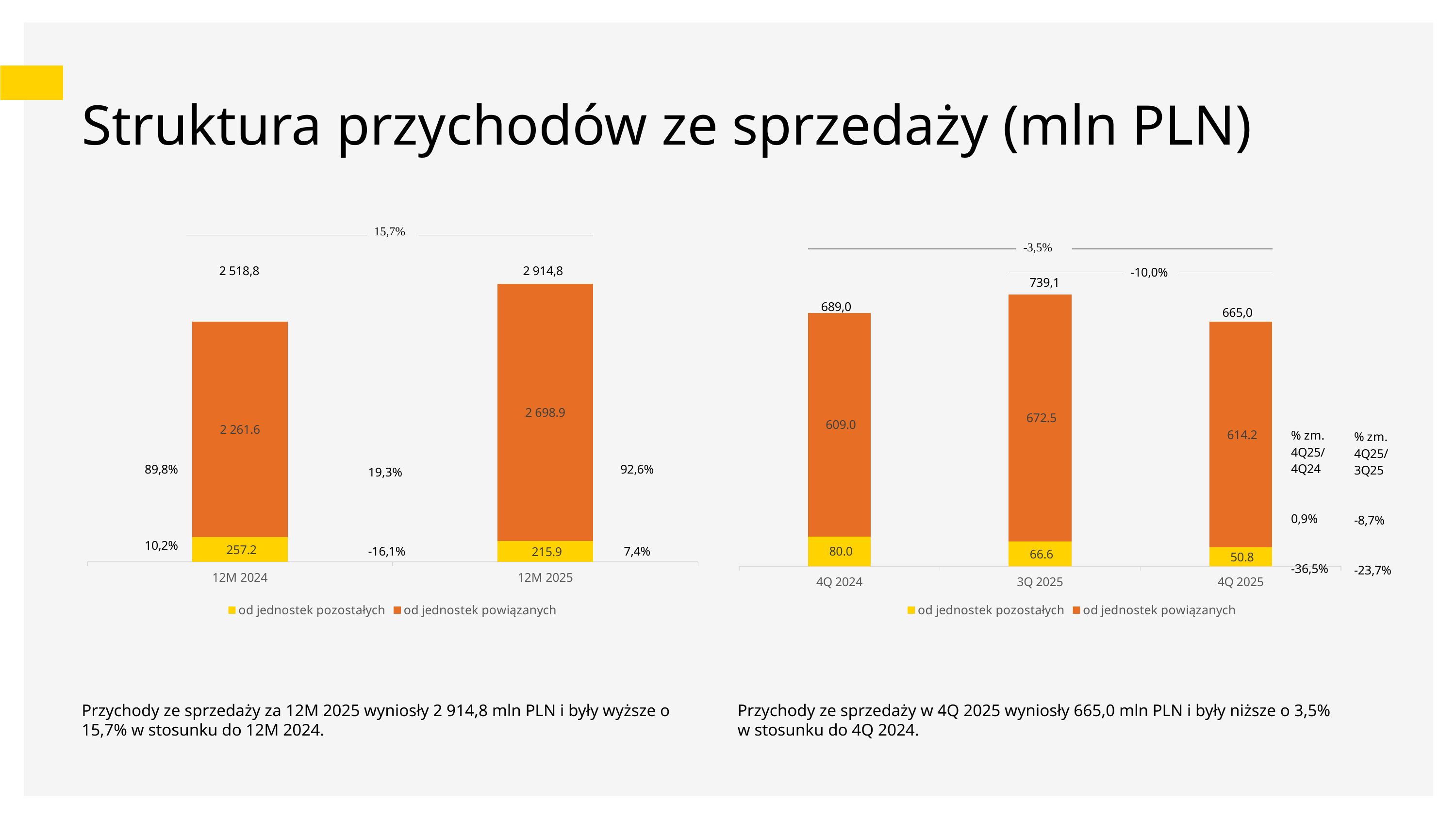
In the left chart, what percentage change is shown between 12M 2024 and 12M 2025? 15,7% How many quarters are shown on the x axis of the right chart? 3 In the left chart, what is the total shown above the 12M 2025 bar? 2 914,8 In the right chart, which quarter has the lowest value for 'od jednostek pozostałych'? 4Q 2025 In the left chart, what is the value of 'od jednostek pozostałych' for 12M 2024? 257.2 In the right chart, what is the difference between the 'od jednostek pozostałych' values for 4Q 2024 and 4Q 2025? 29.2 In the right chart, what is the value of 'od jednostek pozostałych' for 4Q 2025? 50.8 In the right chart, what is the value of 'od jednostek powiązanych' for 3Q 2025? 672.5 What type of chart is the left chart? Stacked bar chart In the left chart, what is the value of 'od jednostek powiązanych' for 12M 2025? 2 698.9 In the right chart, which quarter has the highest total revenue? 3Q 2025 In the left chart, which period has the larger value for 'od jednostek pozostałych', 12M 2024 or 12M 2025? 12M 2024